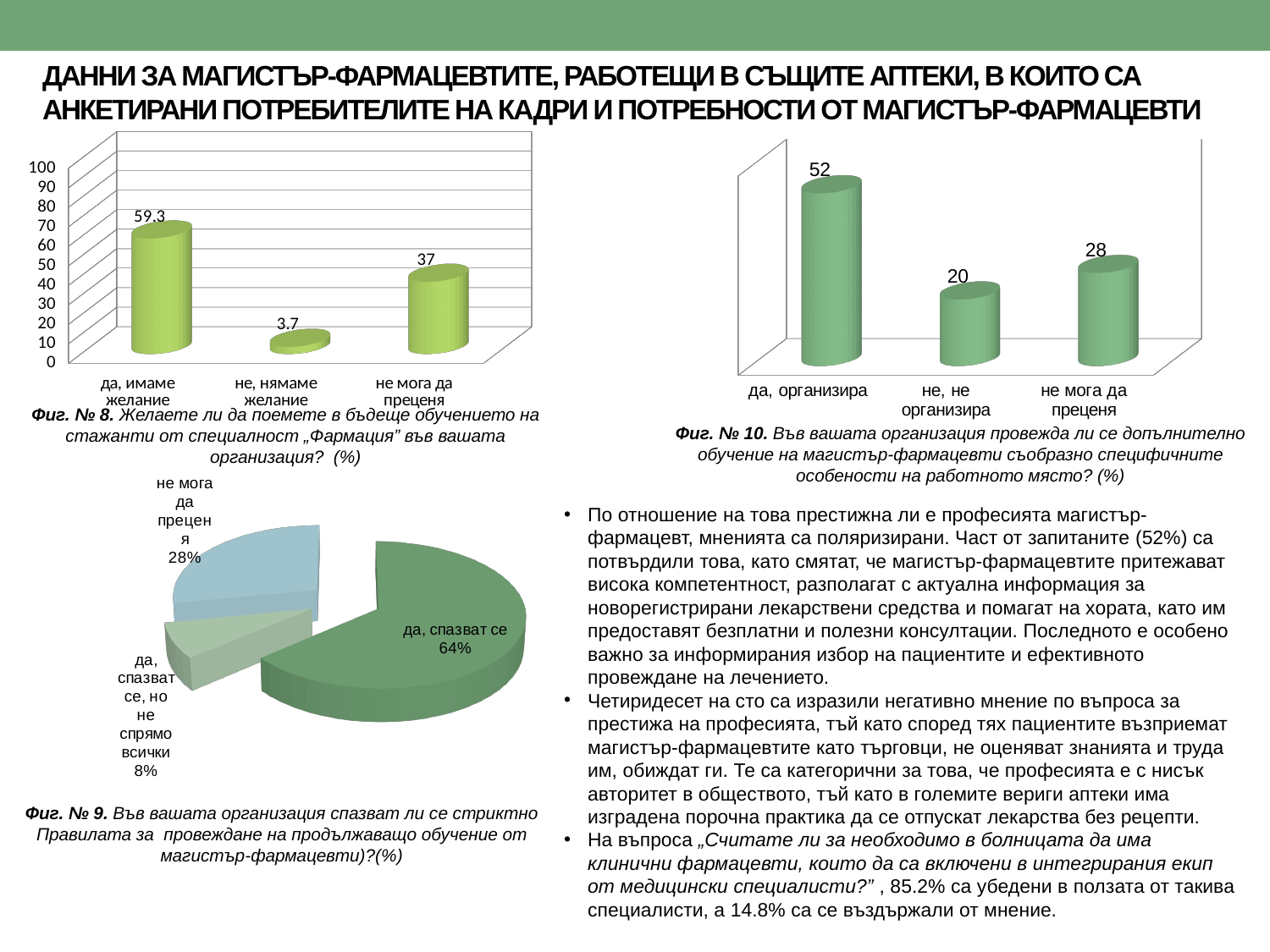
What type of chart is used for Фиг. № 9? pie chart In the chart for Фиг. № 8, what is the difference between the values for "да, имаме желание" and "не мога да преценя"? 22.3 In the chart for Фиг. № 10, which category has the highest value? да, организира In the pie chart for Фиг. № 9, which slice is the smallest? да, спазват се, но не спрямо всички In the chart for Фиг. № 10, what is the value for "не, не организира"? 20 In the chart for Фиг. № 8, what is the value for "да, имаме желание"? 59.3 What type of chart is used for Фиг. № 8? bar chart In the pie chart for Фиг. № 9, what share does "да, спазват се" have? 64% In the chart for Фиг. № 10, what is the difference between the values for "да, организира" and "не мога да преценя"? 24 In the chart for Фиг. № 10, which is larger: the value for "не, не организира" or "не мога да преценя"? не мога да преценя In the chart for Фиг. № 8, which category has the lowest value? не, нямаме желание In the chart for Фиг. № 8, how many categories are shown? 3